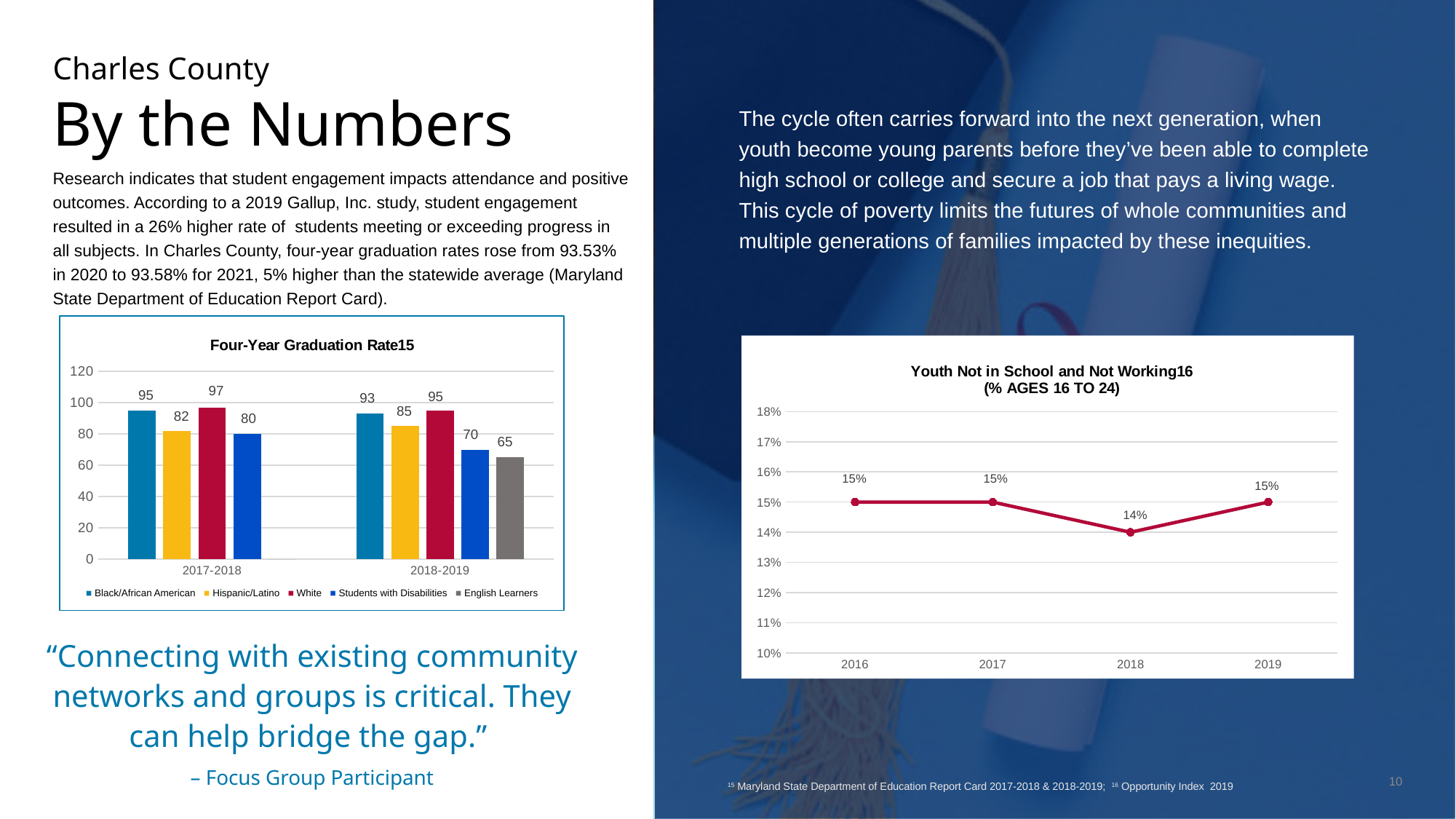
In the Four-Year Graduation Rate chart, which series has the lowest value in 2017-2018? Students with Disabilities In the Four-Year Graduation Rate chart, what is the difference between the Black/African American value and the Hispanic/Latino value in 2017-2018? 13 What kind of chart is the Youth Not in School and Not Working chart? Line chart In the Four-Year Graduation Rate chart, what is the value for Students with Disabilities in 2018-2019? 70 How many years are plotted in the Youth Not in School and Not Working chart? 4 In the Four-Year Graduation Rate chart, what is the value for White in 2017-2018? 97 In the Four-Year Graduation Rate chart, is the Hispanic/Latino value larger in 2017-2018 or 2018-2019? 2018-2019 In the Four-Year Graduation Rate chart, which series has the highest value in 2018-2019? White In the Four-Year Graduation Rate chart, what is the value for English Learners in 2018-2019? 65 In the Youth Not in School and Not Working chart, what is the value for 2018? 14% What kind of chart is the Four-Year Graduation Rate chart? Bar chart How many series does the legend of the Four-Year Graduation Rate chart list? 5